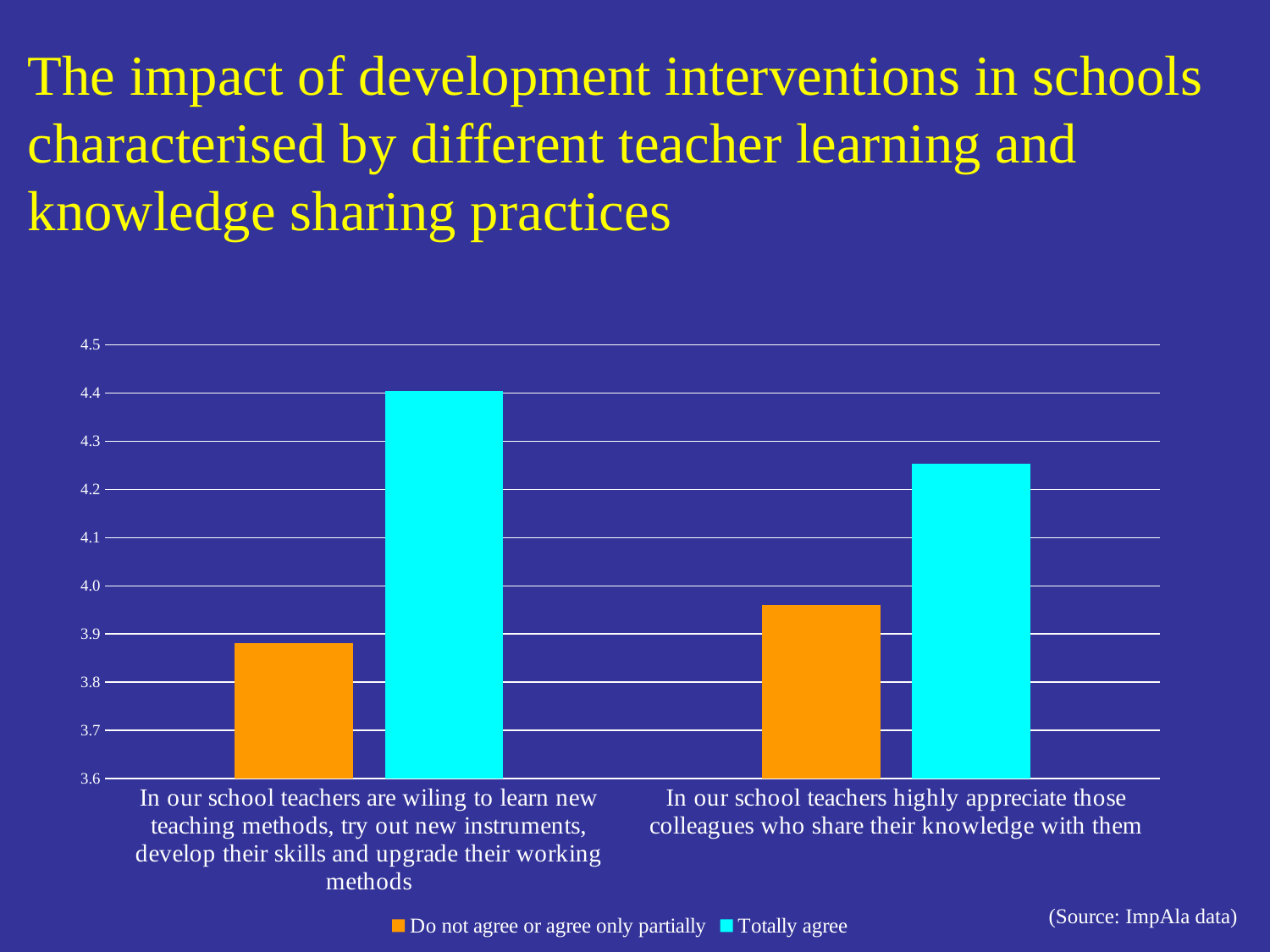
How many categories are shown on the x axis of the chart? 2 Is the 'Totally agree' value for 'In our school teachers highly appreciate those colleagues who share their knowledge with them' greater or less than 4.2? greater Which series has the higher value for 'In our school teachers highly appreciate those colleagues who share their knowledge with them'? Totally agree What kind of chart is shown on the slide? bar chart What source is cited for the chart data on the slide? ImpAla data Which series has the higher value for 'In our school teachers are wiling to learn new teaching methods, try out new instruments, develop their skills and upgrade their working methods'? Totally agree Is the 'Do not agree or agree only partially' value for 'In our school teachers are wiling to learn new teaching methods, try out new instruments, develop their skills and upgrade their working methods' greater or less than 4.0? less How many series does the chart's legend list? 2 Which colour represents the 'Totally agree' series in the chart? cyan Which bar is the highest in the chart? Totally agree for 'In our school teachers are wiling to learn new teaching methods, try out new instruments, develop their skills and upgrade their working methods' Which bar is the lowest in the chart? Do not agree or agree only partially for 'In our school teachers are wiling to learn new teaching methods, try out new instruments, develop their skills and upgrade their working methods' Is the 'Totally agree' value for 'In our school teachers are wiling to learn new teaching methods, try out new instruments, develop their skills and upgrade their working methods' greater or less than 4.3? greater